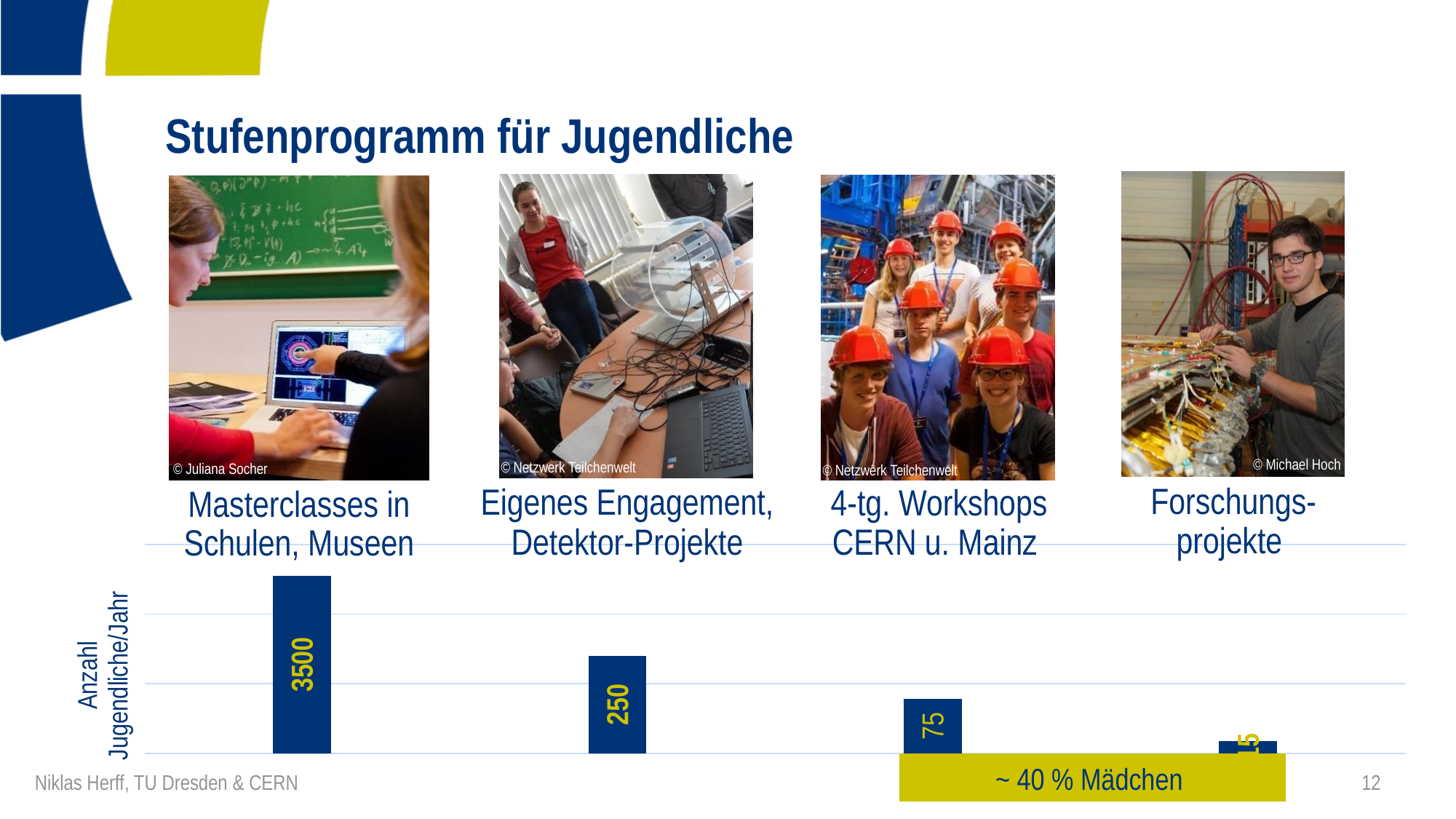
Which category has the highest value? Masterclasses in Schulen, Museen What is the difference between the values for Masterclasses in Schulen, Museen and Eigenes Engagement, Detektor-Projekte? 3250 Which is larger: the value for Eigenes Engagement, Detektor-Projekte or the value for 4-tg. Workshops CERN u. Mainz? Eigenes Engagement, Detektor-Projekte What kind of chart is shown on the slide? bar chart What is the value for Eigenes Engagement, Detektor-Projekte? 250 What is the difference between the values for Eigenes Engagement, Detektor-Projekte and 4-tg. Workshops CERN u. Mainz? 175 How many bars are shown in the chart? 4 What is the value for 4-tg. Workshops CERN u. Mainz? 75 Which category has the lowest value? Forschungsprojekte What is the label on the vertical axis of the chart? Anzahl Jugendliche/Jahr Do the values rise or fall from left to right across the chart? fall What is the value for Masterclasses in Schulen, Museen? 3500